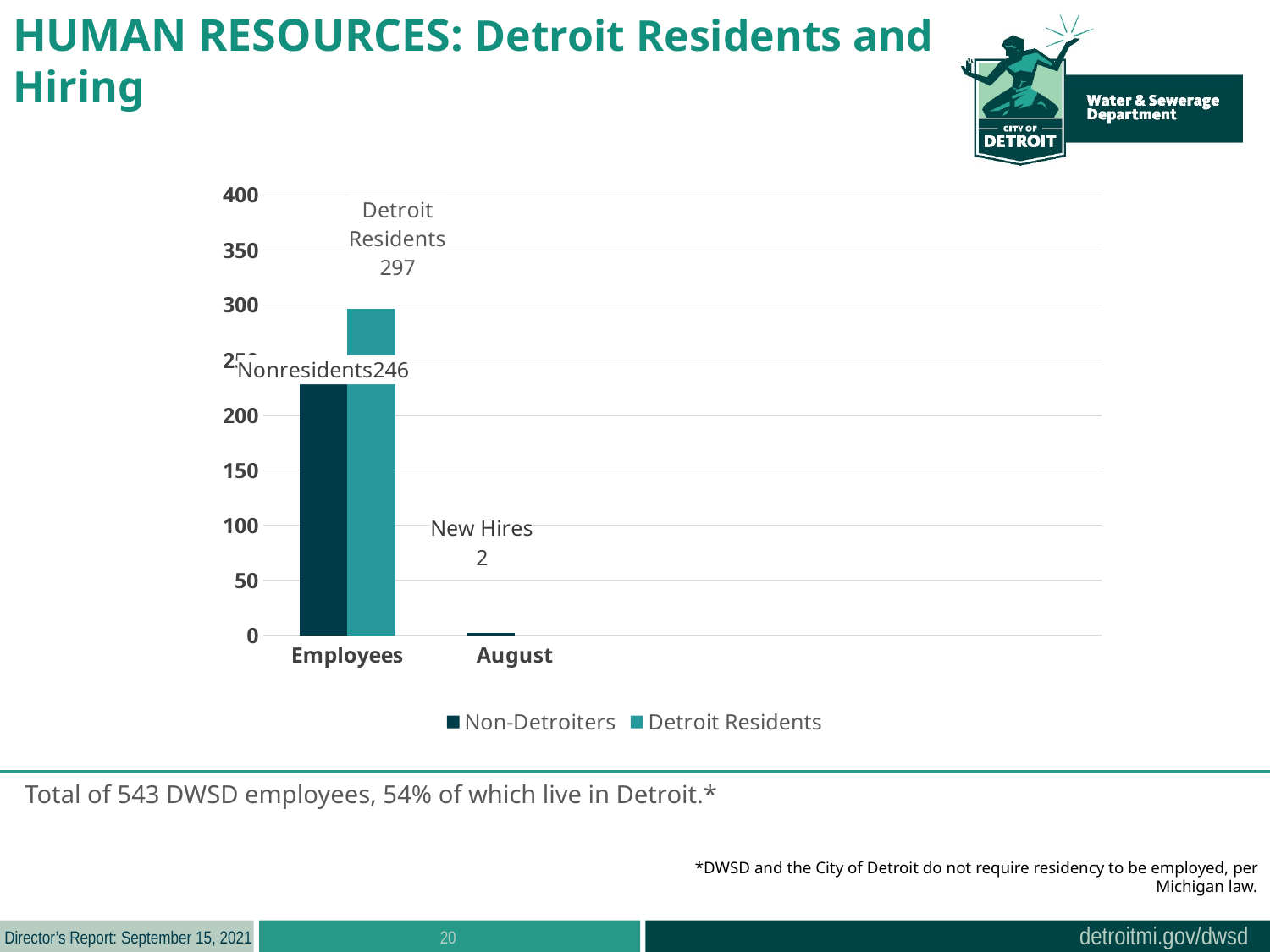
Which category has the lowest bar on the chart? August How many categories are shown on the x axis? 2 What is the value labelled for Detroit Residents in the Employees category? 297 How many series does the legend list? 2 In the Employees category, which is larger: Detroit Residents or Nonresidents? Detroit Residents Is the Detroit Residents bar in the Employees category greater or less than 300? less What is the value labelled for Nonresidents in the Employees category? 246 Is the Nonresidents bar in the Employees category greater or less than 200? greater What is the value labelled for New Hires in the August category? 2 What is the difference between Detroit Residents (297) and Nonresidents (246) in the Employees category? 51 What kind of chart is shown on the slide? bar chart What are the two series named in the legend? Non-Detroiters and Detroit Residents